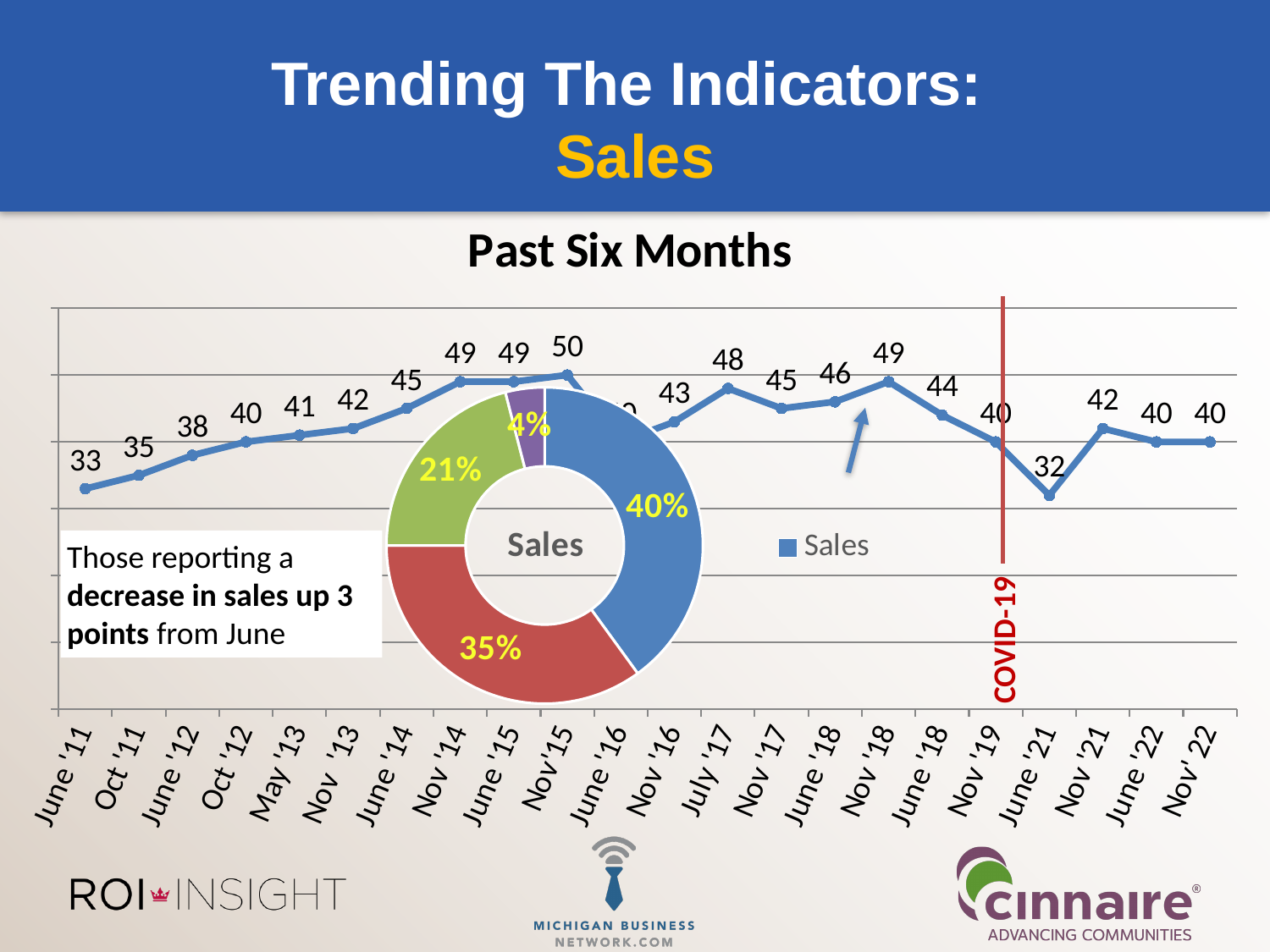
How many periods are labelled on the x axis of the 'Past Six Months' line chart? 22 On the 'Past Six Months' line chart, which is larger, the value for Nov '19 or the value for Nov '21? Nov '21 On the 'Past Six Months' line chart, what is the difference between the values for Nov '18 and June '21? 17 On the 'Past Six Months' line chart, what is the value for Nov '22? 40 On the 'Past Six Months' line chart, what is the value for June '11? 33 On the 'Past Six Months' line chart, which period has the highest value? Nov '15 How many slices does the 'Sales' donut chart have? 4 What label is written on the vertical red line in the 'Past Six Months' line chart? COVID-19 On the 'Past Six Months' line chart, which period has the lowest value? June '21 What kind of chart is the 'Past Six Months' chart? Line chart On the 'Past Six Months' line chart, do the values rise or fall from June '11 to Nov '15? Rise On the 'Sales' donut chart, what is the share of the largest slice? 40%